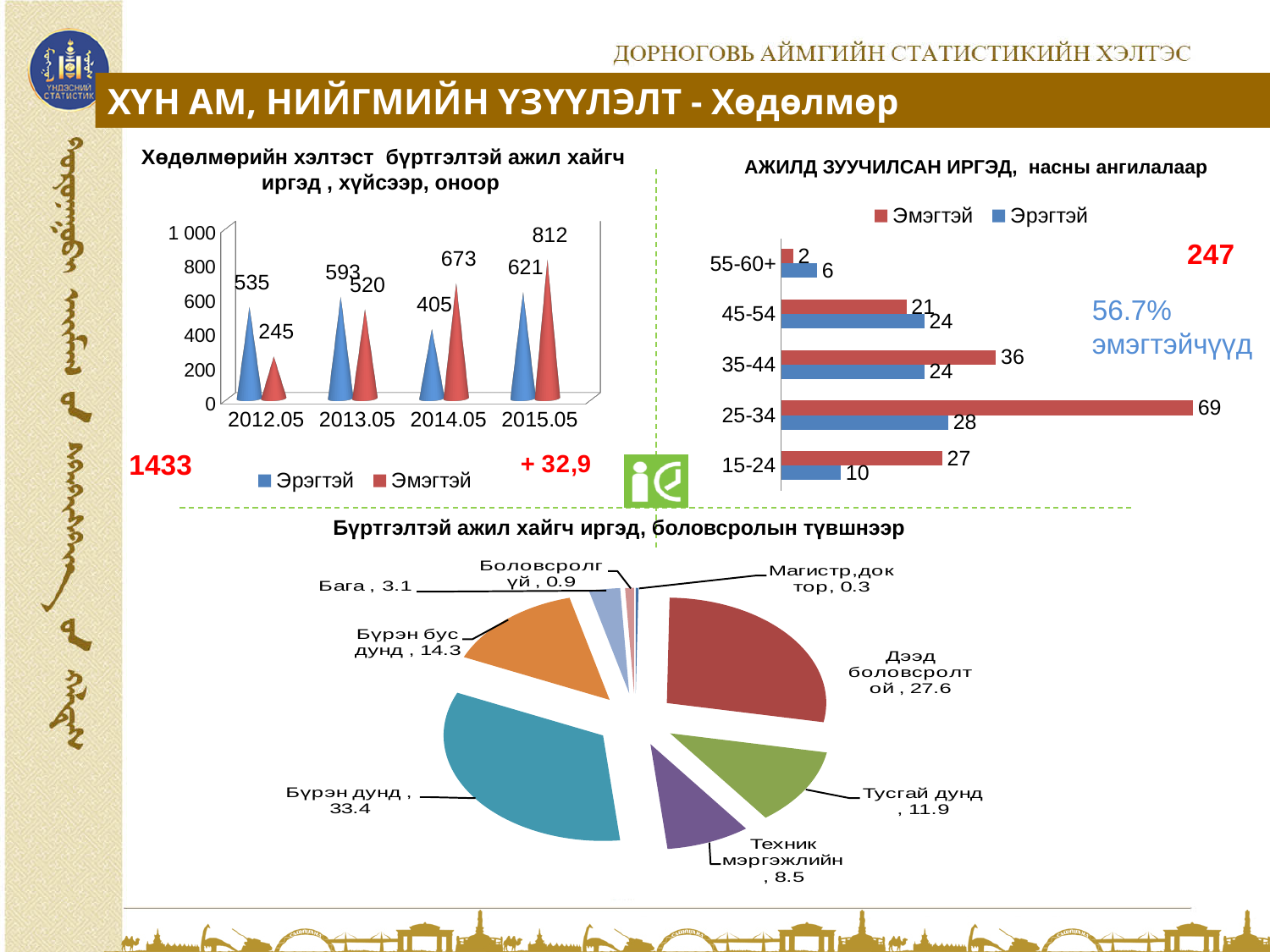
In the chart 'АЖИЛД ЗУУЧИЛСАН ИРГЭД, насны ангилалаар', how many series does the legend list? 2 In the chart 'АЖИЛД ЗУУЧИЛСАН ИРГЭД, насны ангилалаар', which age group has the lowest Эрэгтэй value? 55-60+ In the chart 'Бүртгэлтэй ажил хайгч иргэд, боловсролын түвшнээр', what is the value for Бүрэн дунд? 33.4 In the chart 'Хөдөлмөрийн хэлтэст бүртгэлтэй ажил хайгч иргэд, хүйсээр, оноор', does the Эмэгтэй series rise or fall from 2012.05 to 2015.05? rise In the chart 'АЖИЛД ЗУУЧИЛСАН ИРГЭД, насны ангилалаар', what is the value for Эмэгтэй in the 25-34 age group? 69 In the chart 'Хөдөлмөрийн хэлтэст бүртгэлтэй ажил хайгч иргэд, хүйсээр, оноор', how many years are shown on the x axis? 4 In the chart 'Хөдөлмөрийн хэлтэст бүртгэлтэй ажил хайгч иргэд, хүйсээр, оноор', what is the value for Эмэгтэй in 2015.05? 812 What kind of chart is 'Бүртгэлтэй ажил хайгч иргэд, боловсролын түвшнээр'? pie chart In the chart 'АЖИЛД ЗУУЧИЛСАН ИРГЭД, насны ангилалаар', which is larger in the 45-54 age group, Эмэгтэй or Эрэгтэй? Эрэгтэй In the chart 'Хөдөлмөрийн хэлтэст бүртгэлтэй ажил хайгч иргэд, хүйсээр, оноор', what is the difference between Эмэгтэй and Эрэгтэй in 2012.05? 290 In the chart 'Хөдөлмөрийн хэлтэст бүртгэлтэй ажил хайгч иргэд, хүйсээр, оноор', what is the value for Эрэгтэй in 2014.05? 405 In the chart 'Бүртгэлтэй ажил хайгч иргэд, боловсролын түвшнээр', which category has the smallest slice? Магистр,доктор